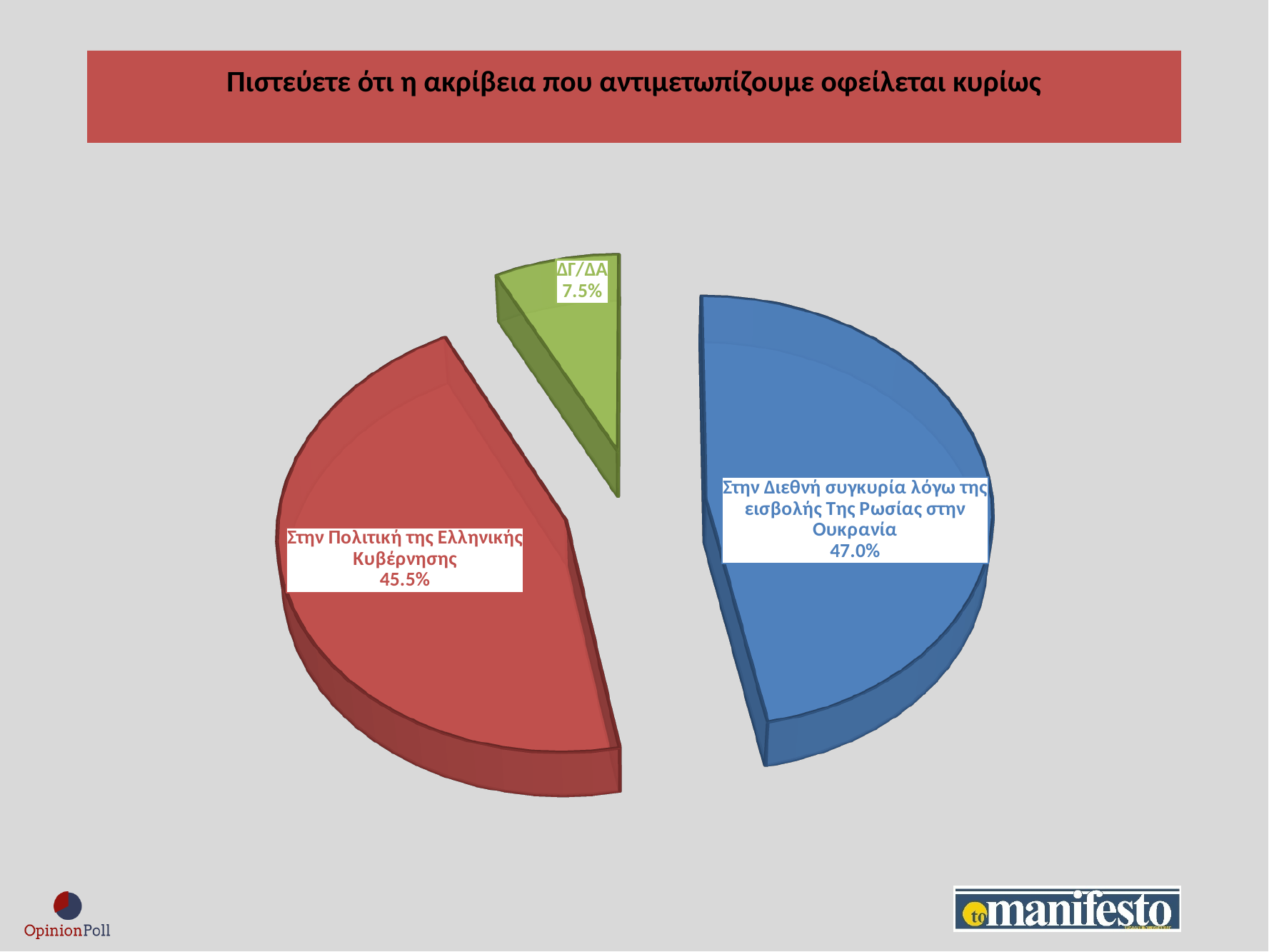
What is the value for "Στην Διεθνή συγκυρία λόγω της εισβολής Της Ρωσίας στην Ουκρανία"? 47.0% Which slice has the smallest share? ΔΓ/ΔΑ What is the title of the chart? Πιστεύετε ότι η ακρίβεια που αντιμετωπίζουμε οφείλεται κυρίως What is the value for "ΔΓ/ΔΑ"? 7.5% What is the value for "Στην Πολιτική της Ελληνικής Κυβέρνησης"? 45.5% What colour is the slice for "ΔΓ/ΔΑ"? green What kind of chart is shown on the slide? pie chart What is the difference between the share for "Στην Διεθνή συγκυρία λόγω της εισβολής Της Ρωσίας στην Ουκρανία" and the share for "Στην Πολιτική της Ελληνικής Κυβέρνησης"? 1.5% Which is larger: the share for "Στην Πολιτική της Ελληνικής Κυβέρνησης" or the share for "ΔΓ/ΔΑ"? Στην Πολιτική της Ελληνικής Κυβέρνησης What is the difference between the share for "Στην Πολιτική της Ελληνικής Κυβέρνησης" and the share for "ΔΓ/ΔΑ"? 38.0% How many slices does the pie chart have? 3 Which slice has the largest share? Στην Διεθνή συγκυρία λόγω της εισβολής Της Ρωσίας στην Ουκρανία